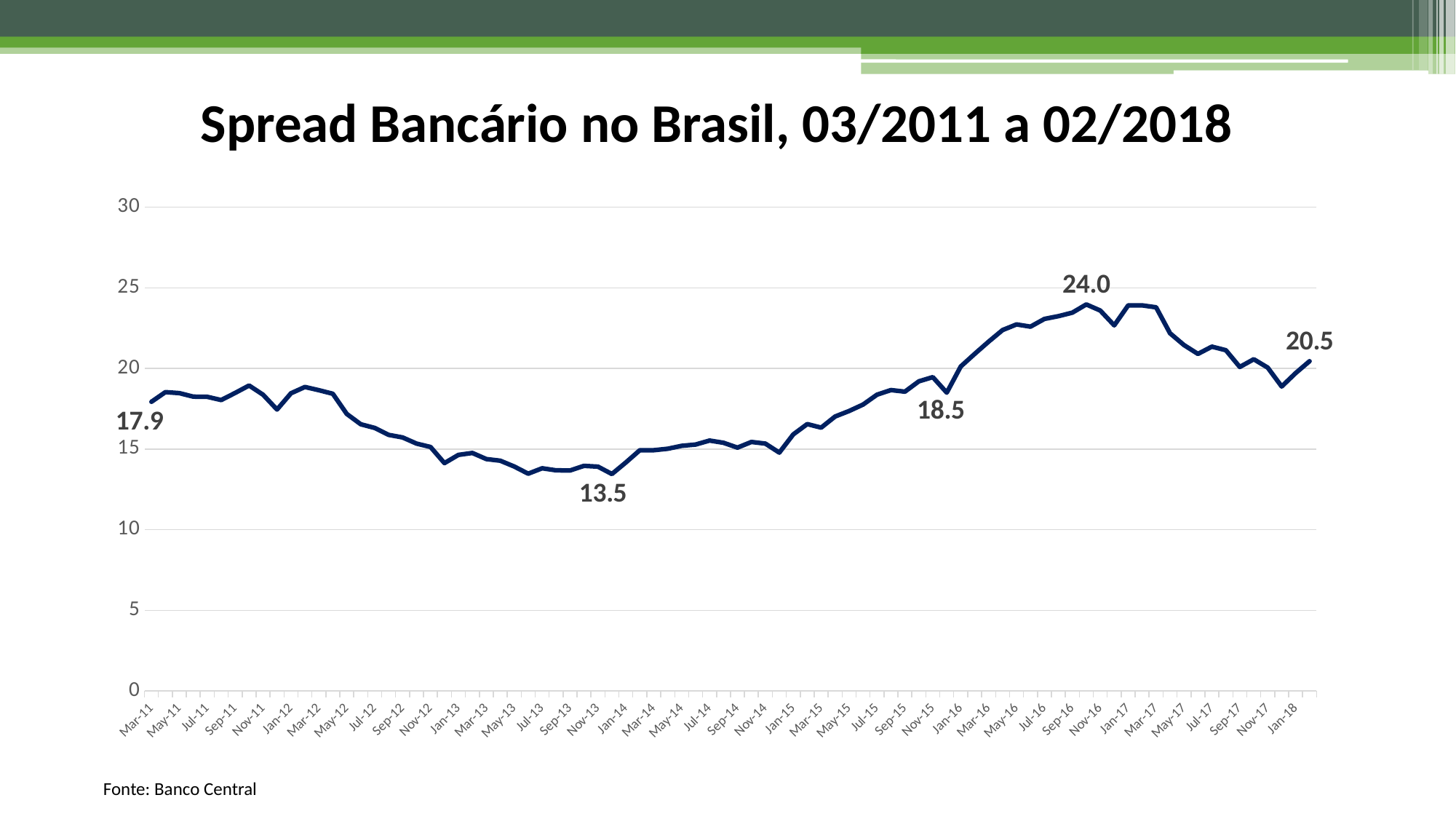
Is the value for Jul-13 greater or less than 15? less Which is larger: the labeled value 18.5 near the end of 2015 or the starting value 17.9 in Mar-11? 18.5 How much higher is the final value (20.5) than the starting value (17.9)? 2.6 What is the lowest labeled value on the chart? 13.5 What is the value of the bank spread at the end of the series (02/2018)? 20.5 What is the difference between the highest labeled value (24.0) and the lowest labeled value (13.5)? 10.5 What kind of chart is shown on the slide? line chart What is the highest labeled value on the chart? 24.0 What source is cited below the chart? Banco Central What is the value of the bank spread at the start of the series (Mar-11)? 17.9 Is the value for Mar-16 greater or less than 20? greater Do the values generally rise or fall between Mar-11 and Nov-13? fall